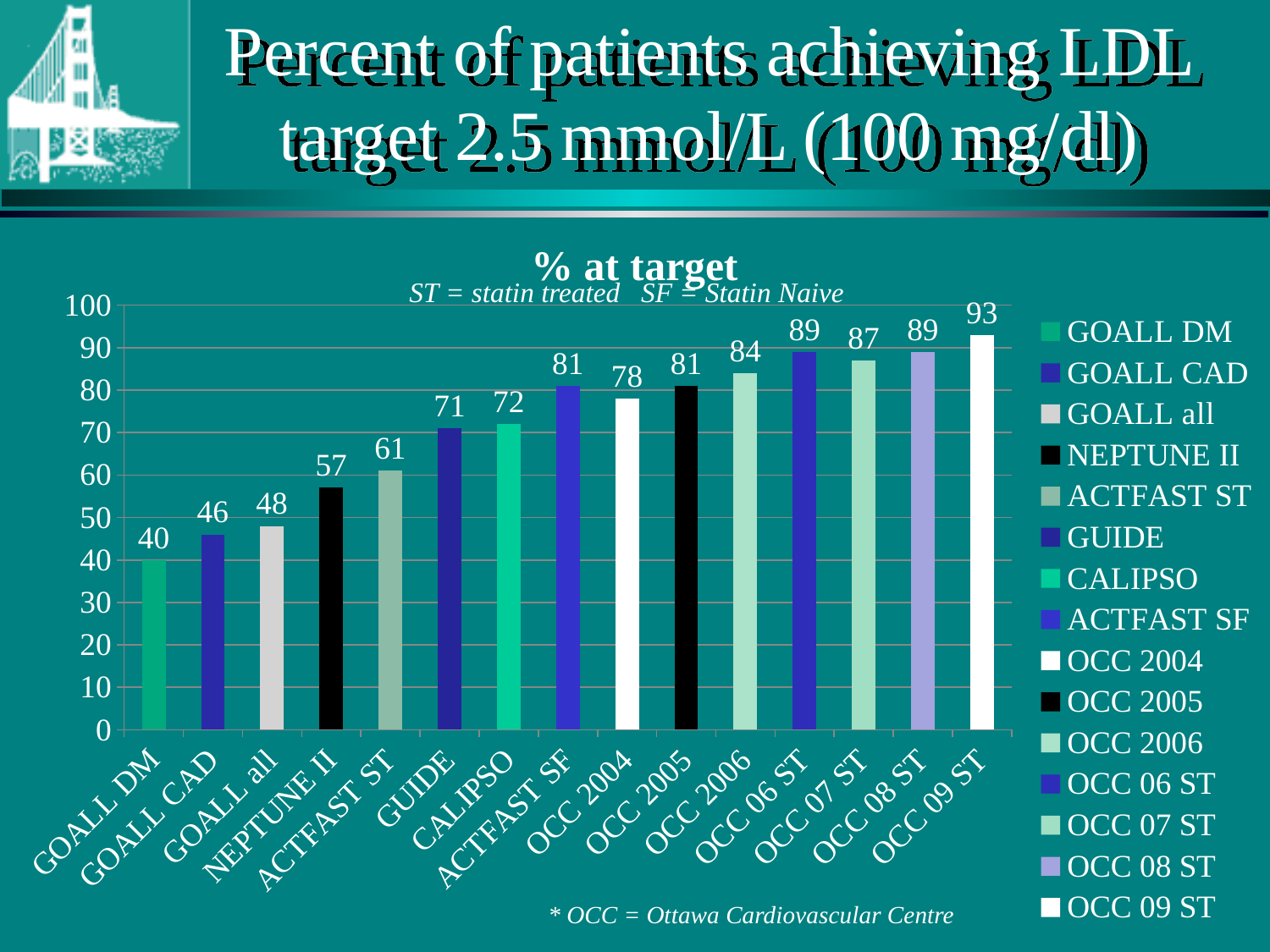
How many categories are shown on the x axis? 15 What is the value for OCC 09 ST? 93 What is the title of the chart? % at target Which is larger, the value for OCC 2006 or the value for OCC 2005? OCC 2006 How many entries does the legend list? 15 What is the value for NEPTUNE II? 57 Which category has the highest value? OCC 09 ST What kind of chart is shown on the slide? Bar chart What is the value for OCC 2004? 78 What is the difference between the values for OCC 09 ST and GOALL DM? 53 Which category has the lowest value? GOALL DM What is the difference between the values for CALIPSO and GUIDE? 1